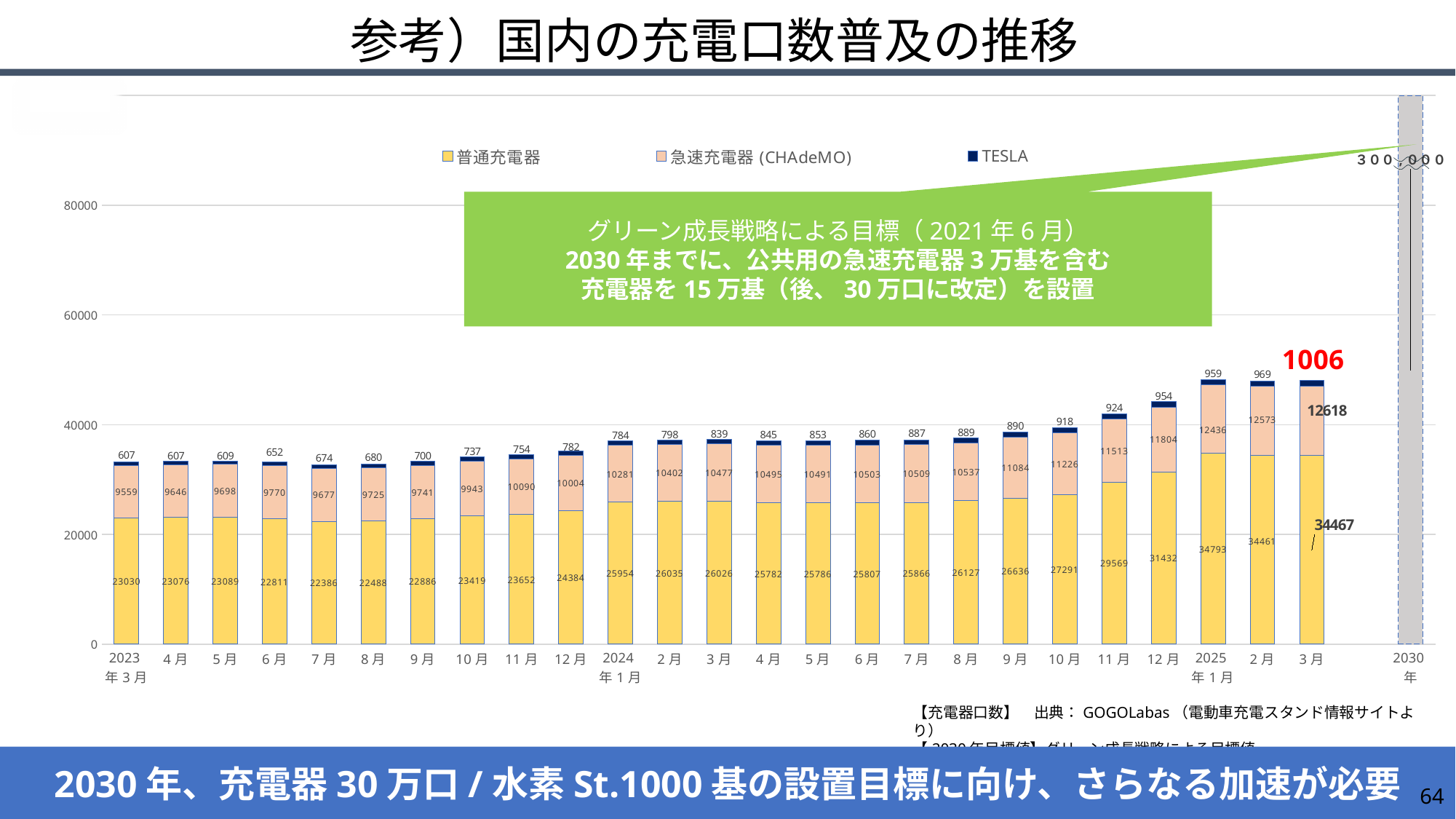
How many series does the chart legend list? 3 What is the value of 普通充電器 for 2025年3月? 34467 What target value is shown for the 2030年 bar? 300,000 What kind of chart is shown on the slide? Stacked bar chart What is the difference between the TESLA value for 2025年3月 and for 2023年3月? 399 What is the total of the stacked bar for 2025年3月? 48091 Is the total height of the 2025年3月 bar greater or less than 40000? greater In which month is the TESLA value highest? 2025年3月 Which is larger, the 急速充電器 (CHAdeMO) value for 2024年12月 or for 2024年11月? 2024年12月 In which month is the 普通充電器 value lowest? 2023年7月 What is the value of 急速充電器 (CHAdeMO) for 2025年1月? 12436 What is the TESLA value for 2024年1月? 784